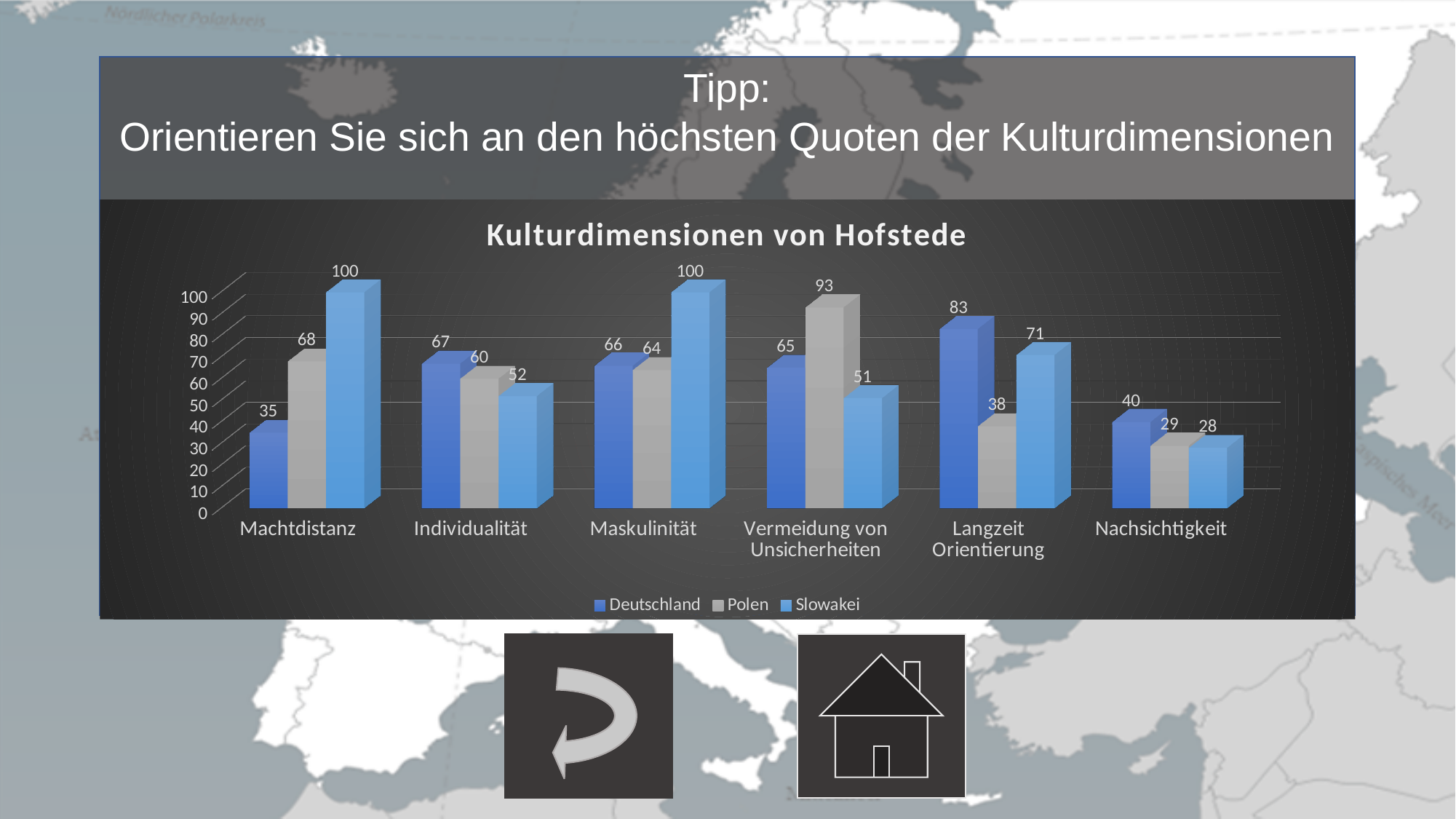
Which is larger in the Individualität category: the value for Deutschland or the value for Polen? Deutschland What kind of chart is shown on the slide? Bar chart What is the title of the chart? Kulturdimensionen von Hofstede Which country has the lowest value in the Nachsichtigkeit category? Slowakei Which country has the highest value in the Langzeit Orientierung category? Deutschland How many categories are shown on the x axis? 6 What is the value for Slowakei in the Langzeit Orientierung category? 71 What is the value for Polen in the Vermeidung von Unsicherheiten category? 93 How many series does the legend list? 3 In which categories does Slowakei reach a value of 100? Machtdistanz and Maskulinität What is the value for Deutschland in the Machtdistanz category? 35 What is the difference between the Slowakei and Deutschland values in the Machtdistanz category? 65